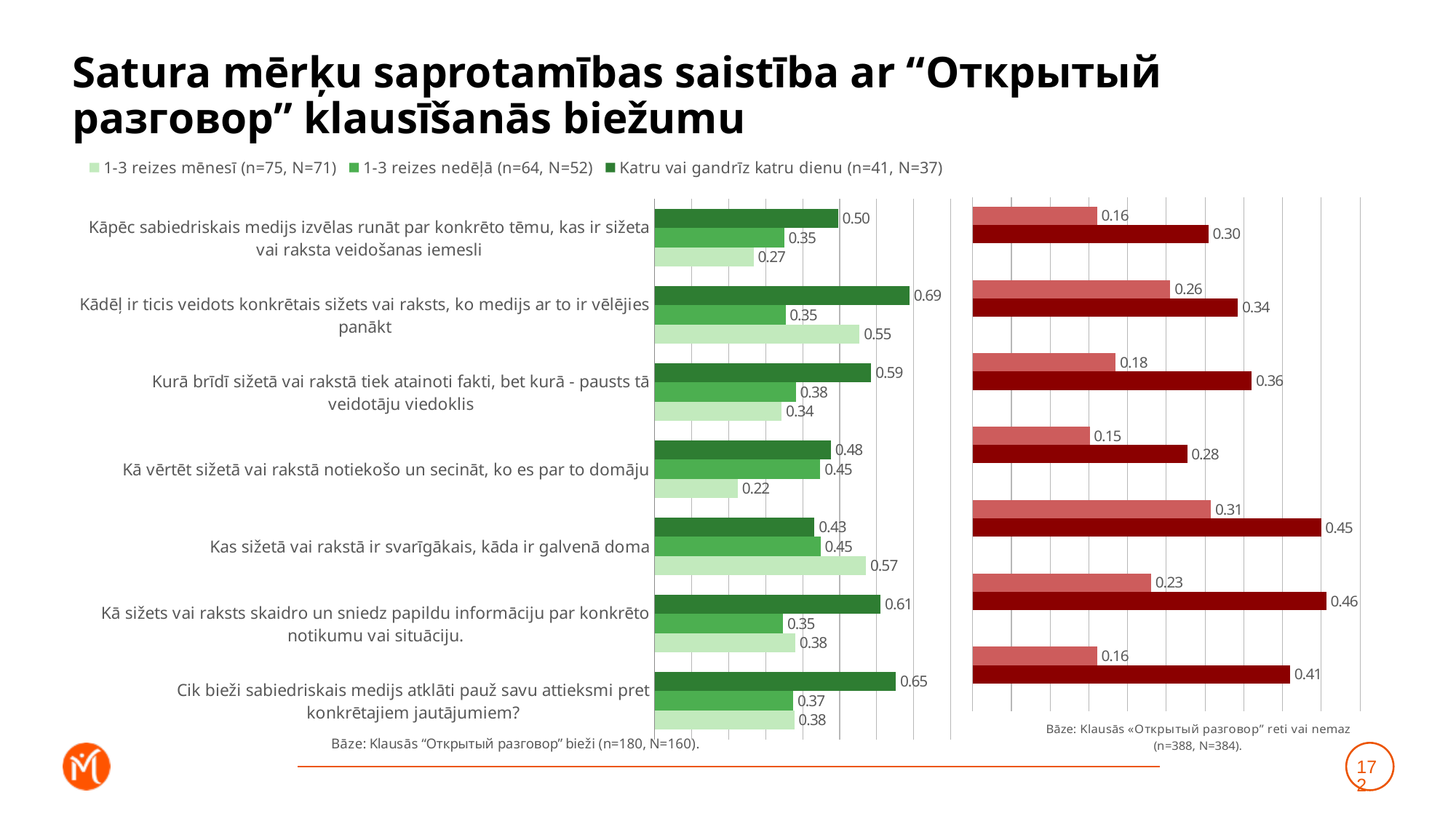
In the left (green) chart, which category has the highest value for the "Katru vai gandrīz katru dienu" series? Kādēļ ir ticis veidots konkrētais sižets vai raksts, ko medijs ar to ir vēlējies panākt In the right (red) chart, which category has the highest value for the lighter red bars? Kas sižetā vai rakstā ir svarīgākais, kāda ir galvenā doma What type of chart is the left (green) chart? Bar chart In the right (red) chart, what is the value of the darker red bar for "Kas sižetā vai rakstā ir svarīgākais, kāda ir galvenā doma"? 0.45 How many categories are shown in the left (green) chart? 7 In the left (green) chart, which category has the lowest value for the "1-3 reizes mēnesī" series? Kā vērtēt sižetā vai rakstā notiekošo un secināt, ko es par to domāju What is the first entry in the legend of the left (green) chart? 1-3 reizes mēnesī (n=75, N=71) In the left (green) chart, for "Kas sižetā vai rakstā ir svarīgākais, kāda ir galvenā doma", which series has the larger value: "1-3 reizes mēnesī" or "Katru vai gandrīz katru dienu"? 1-3 reizes mēnesī How many series does the legend of the left (green) chart list? 3 In the left (green) chart, what is the difference between the "Katru vai gandrīz katru dienu" and "1-3 reizes mēnesī" values for "Kādēļ ir ticis veidots konkrētais sižets vai raksts, ko medijs ar to ir vēlējies panākt"? 0.14 In the left (green) chart, what is the value for "1-3 reizes mēnesī" for the category "Kā vērtēt sižetā vai rakstā notiekošo un secināt, ko es par to domāju"? 0.22 In the left (green) chart, what is the value for "Katru vai gandrīz katru dienu" for the category "Kādēļ ir ticis veidots konkrētais sižets vai raksts, ko medijs ar to ir vēlējies panākt"? 0.69